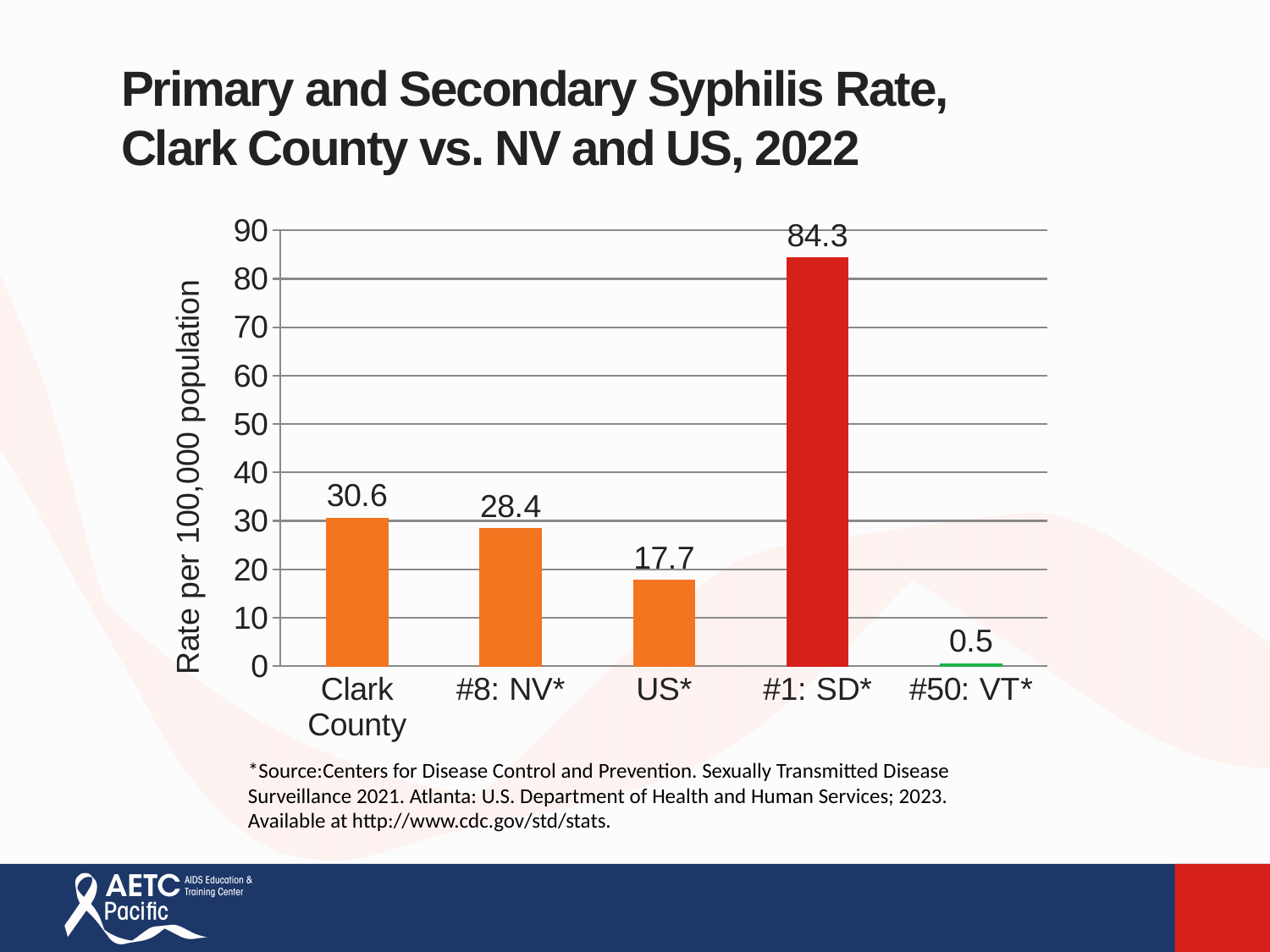
Which category has the lowest rate? #50: VT* What is the rate shown for US*? 17.7 What is the difference between the rate for #1: SD* and the rate for Clark County? 53.7 What is the rate shown for #50: VT*? 0.5 Which category has the highest rate? #1: SD* How many categories are shown on the x axis? 5 What is the rate shown for #8: NV*? 28.4 What is the label of the vertical axis? Rate per 100,000 population What kind of chart is shown on the slide? Bar chart What is the primary and secondary syphilis rate for Clark County? 30.6 What is the difference between the rate for Clark County and the rate for US*? 12.9 Which has a higher rate, Clark County or US*? Clark County